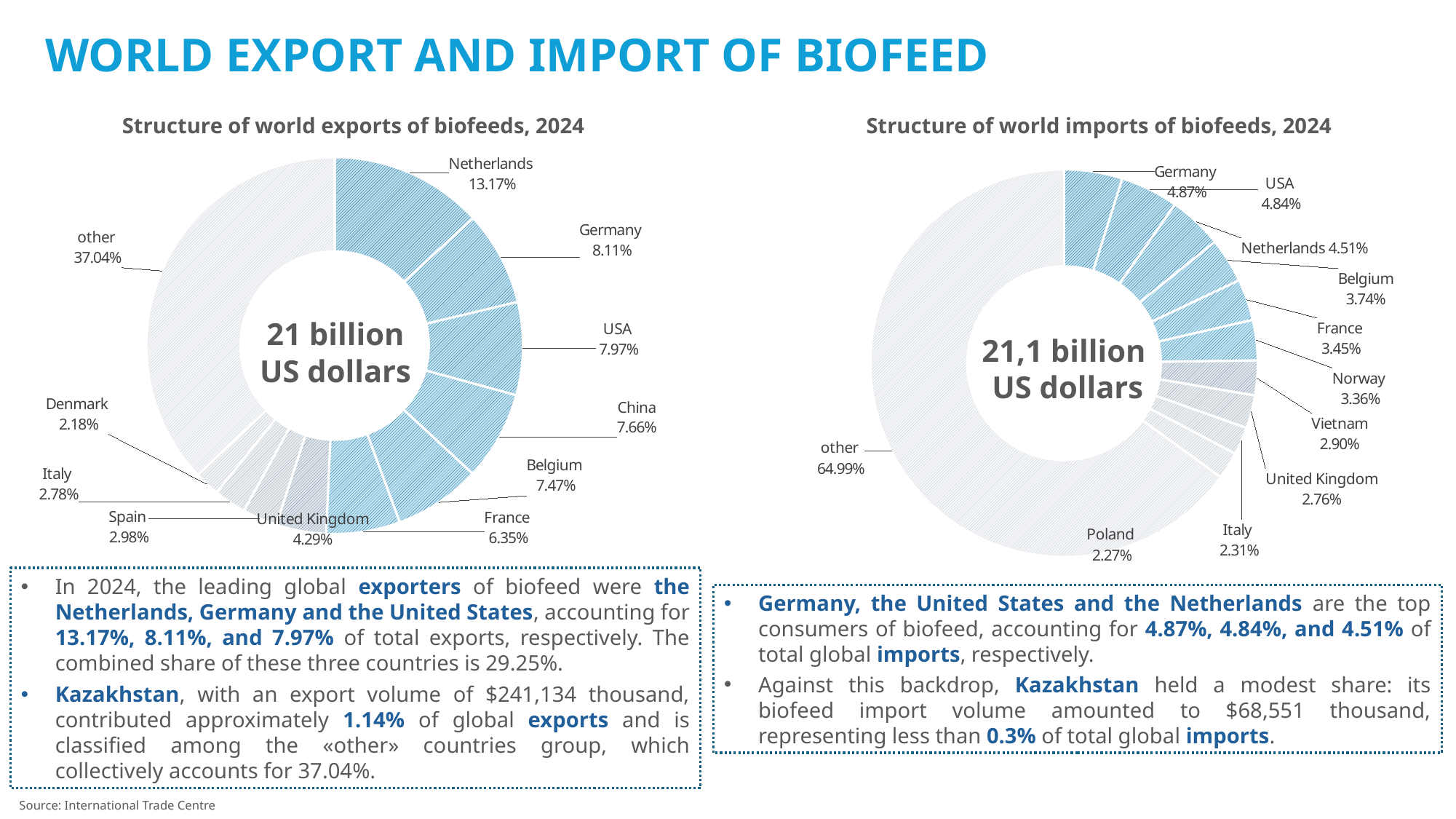
What total value is shown in the centre of the 'Structure of world imports of biofeeds, 2024' chart? 21,1 billion US dollars In the 'Structure of world exports of biofeeds, 2024' chart, which country has the smallest share? Denmark In the 'Structure of world imports of biofeeds, 2024' chart, which has the larger share, Vietnam or the United Kingdom? Vietnam In the 'Structure of world exports of biofeeds, 2024' chart, which has the larger share, China or Belgium? China In the 'Structure of world imports of biofeeds, 2024' chart, what is the share for Norway? 3.36% In the 'Structure of world imports of biofeeds, 2024' chart, which country has the smallest share? Poland In the 'Structure of world imports of biofeeds, 2024' chart, what is the difference in percentage points between Belgium and France? 0.29 percentage points In the 'Structure of world exports of biofeeds, 2024' chart, what is the difference in percentage points between the Netherlands and Germany? 5.06 percentage points How many slices does the 'Structure of world exports of biofeeds, 2024' chart have, including 'other'? 11 In the 'Structure of world exports of biofeeds, 2024' chart, what share of exports does the Netherlands account for? 13.17% What type of chart is used for 'Structure of world imports of biofeeds, 2024'? Pie (donut) chart In the 'Structure of world exports of biofeeds, 2024' chart, which individual country has the largest share? Netherlands